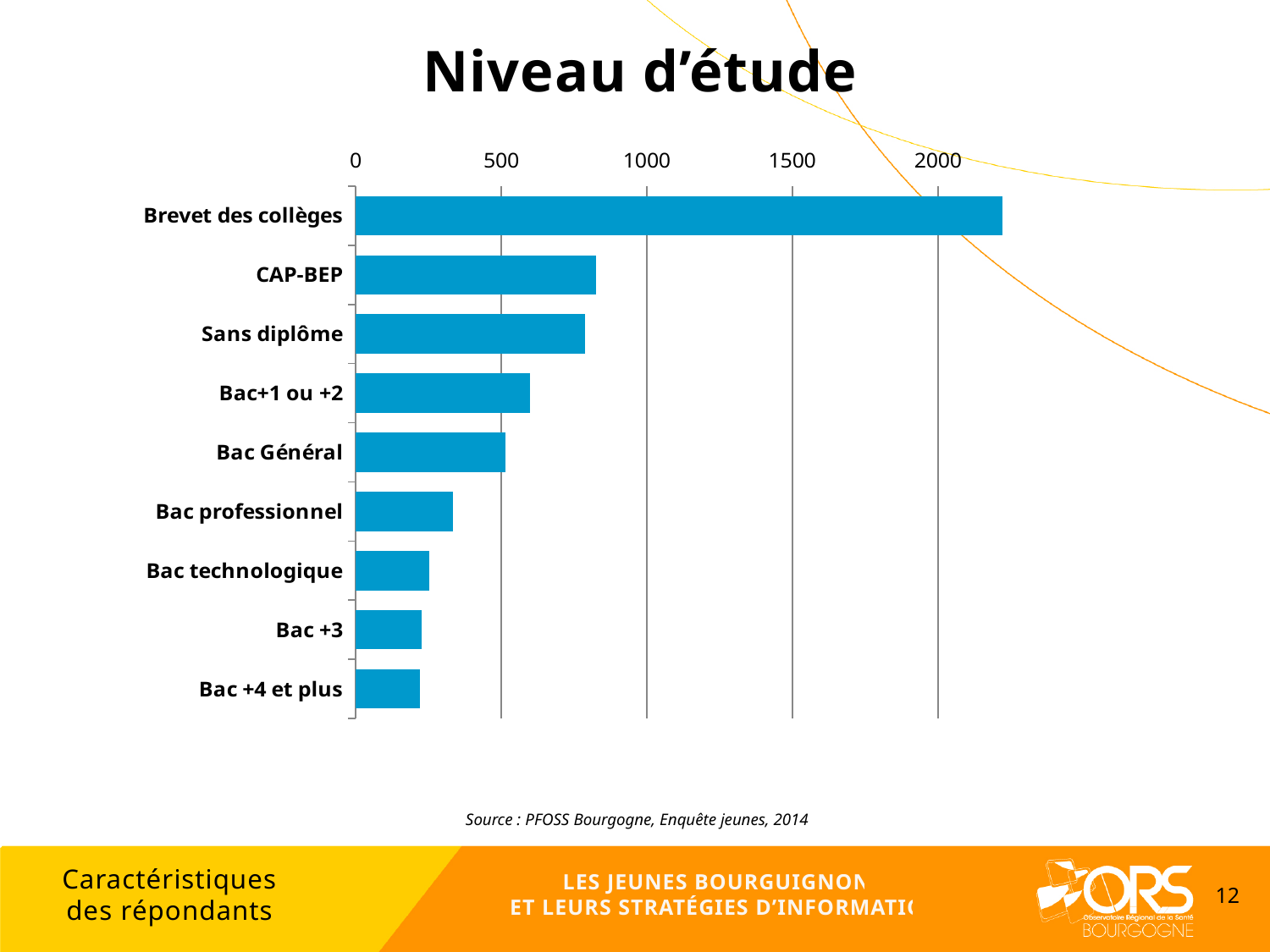
Which is larger, the value for Bac Général or the value for Bac technologique? Bac Général How many categories (education levels) are shown in the chart? 9 Is the value for Bac professionnel greater or less than 500? less What is the title of the chart? Niveau d'étude Is the value for Bac+1 ou +2 greater or less than 500? greater What kind of chart is shown on the slide? bar chart Is the value for Bac +4 et plus greater or less than 500? less Which category has the highest value? Brevet des collèges Which is larger, the value for Brevet des collèges or the value for CAP-BEP? Brevet des collèges